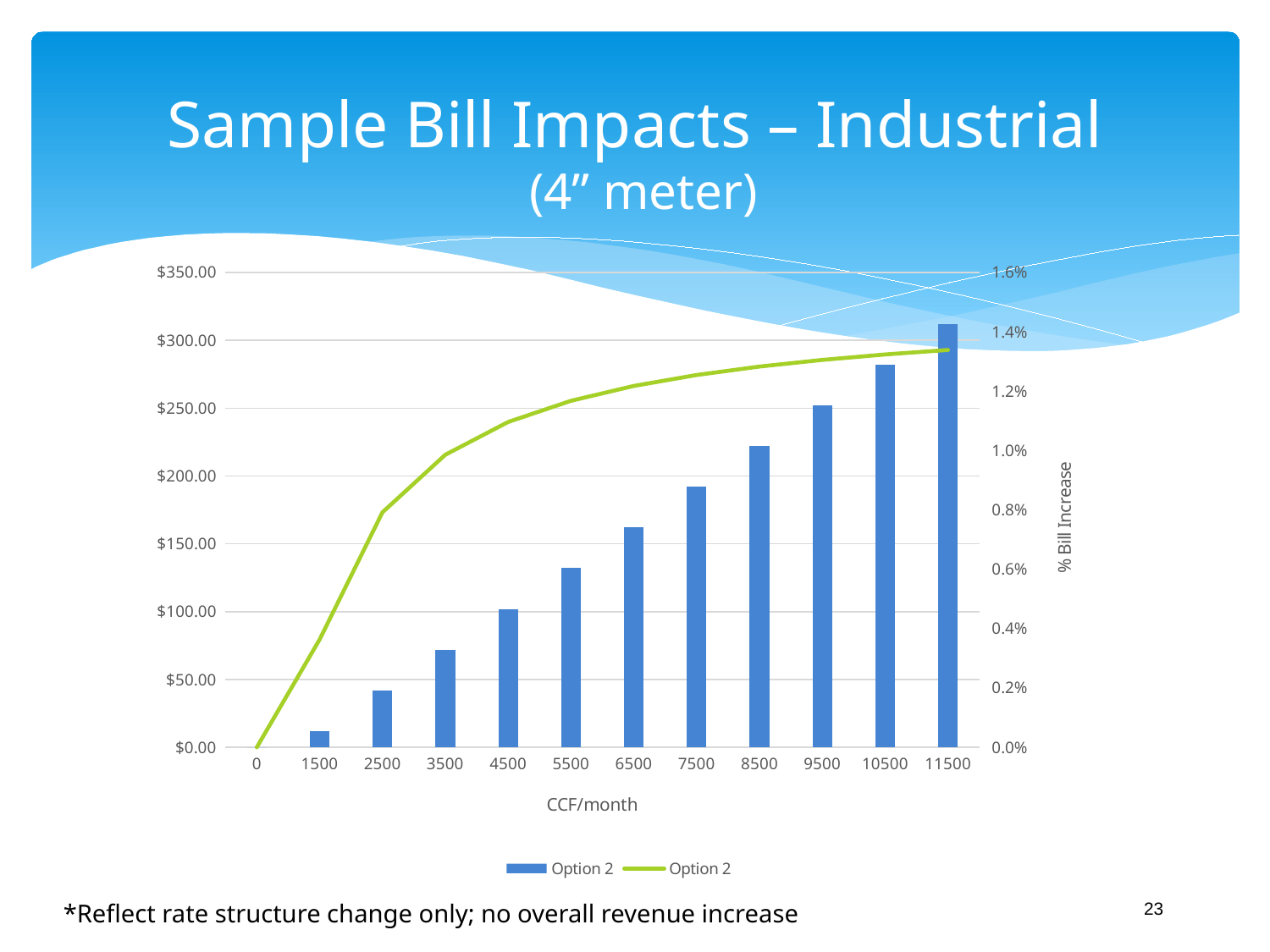
Is the bar value for 10500 CCF/month greater or less than $300.00? less What kind of chart is shown on the slide? A combined bar and line chart Which bar is taller, the one for 9500 CCF/month or the one for 6500 CCF/month? 9500 Is the line value (% Bill Increase) at 11500 CCF/month greater or less than 1.4%? less Do the bar values rise or fall as CCF/month increases along the x axis? Rise How many categories are shown on the x axis? 12 Which CCF/month category has the tallest bar? 11500 How many series does the legend list? 2 What is the title of the x axis? CCF/month Is the bar value for 5500 CCF/month greater or less than $100.00? greater